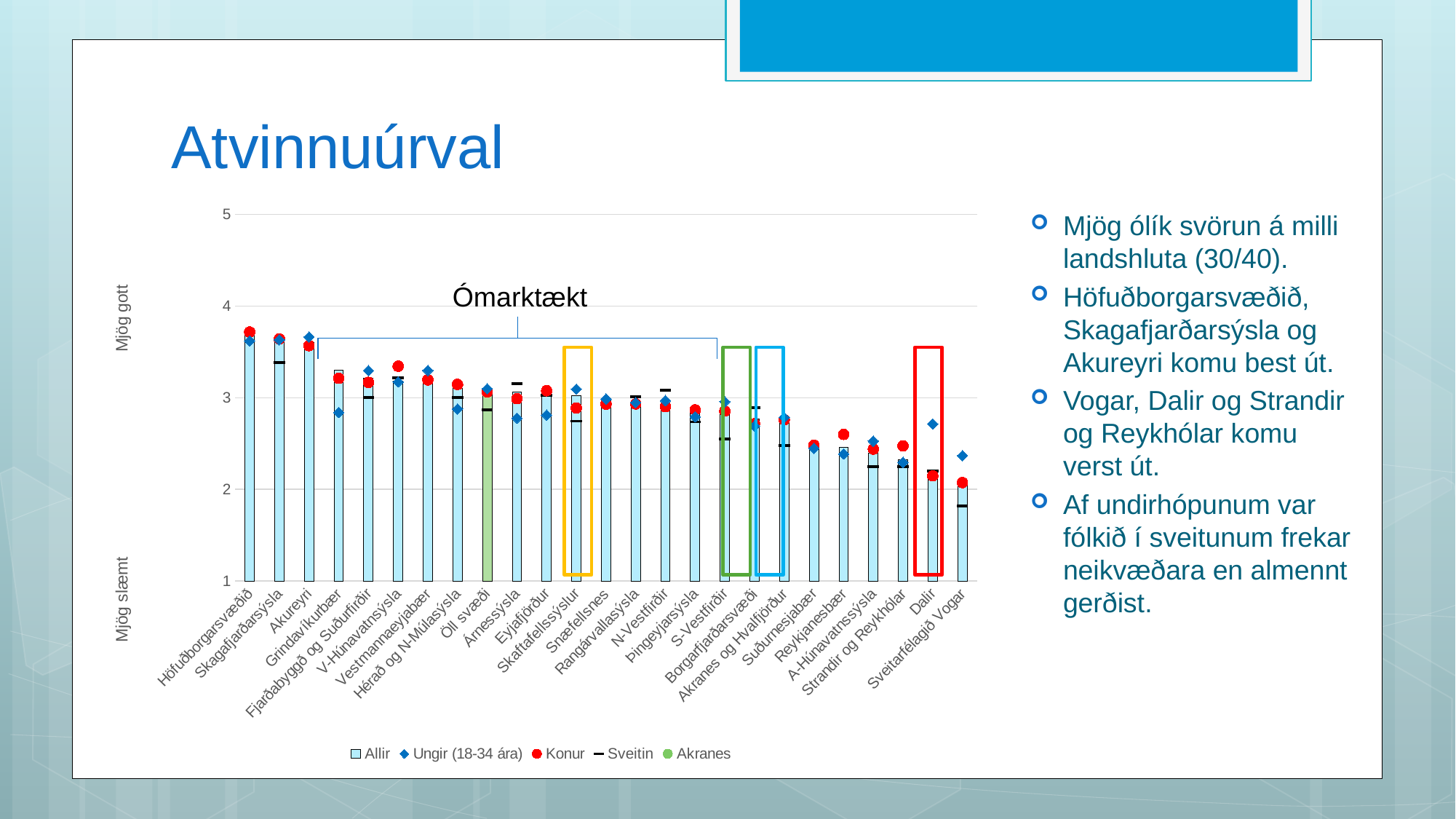
Is the Allir value for Grindavíkurbær greater or less than 3? greater Is the Allir value for Dalir greater or less than 3? less Do the Allir bar values generally rise or fall from left to right along the x axis? fall Is the Allir value for Sveitarfélagið Vogar greater or less than 3? less How many categories are shown along the x axis of the chart? 25 How many series does the chart legend list? 5 What is the title of the slide containing the chart? Atvinnuúrval Which has the larger Allir value, Höfuðborgarsvæðið or Dalir? Höfuðborgarsvæðið Which category's bar is coloured green in the chart? Öll svæði What kind of chart is shown on the slide? bar chart